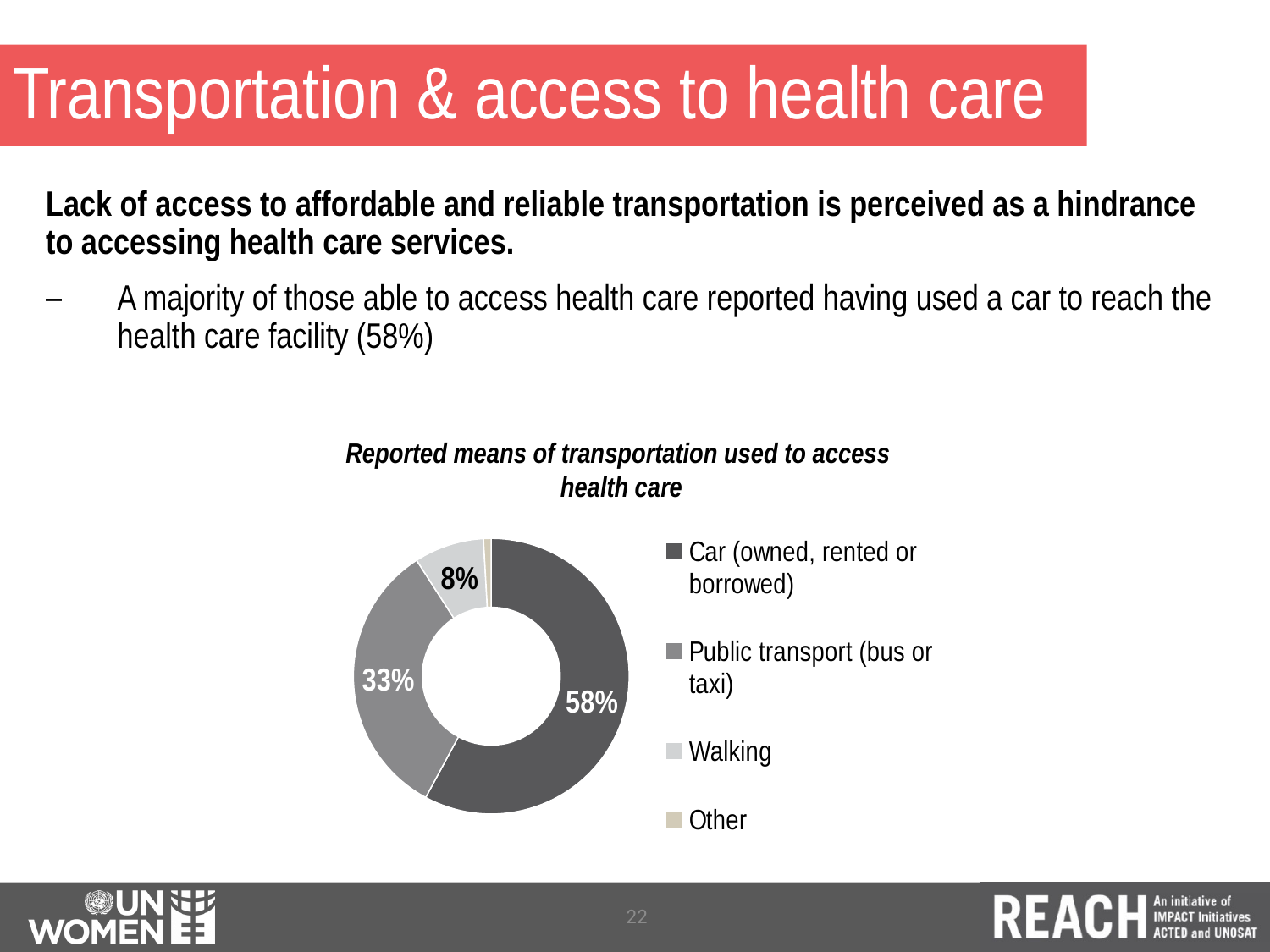
Which means of transportation has the largest share in the chart? Car (owned, rented or borrowed) Is the share for public transport (bus or taxi) greater or less than 50%? less Which is larger: the share for public transport (bus or taxi) or the share for walking? Public transport (bus or taxi) How many categories does the chart's legend list? 4 What kind of chart is shown on the slide? Pie chart (doughnut) What share of respondents reported using public transport (bus or taxi) to access health care? 33% Which means of transportation has the smallest share in the chart? Other What is the difference in percentage points between the car share and the public transport share? 25 percentage points What share of respondents reported walking to access health care? 8% Which legend entry is shown in the lightest grey colour? Walking What share of respondents reported using a car (owned, rented or borrowed) to access health care? 58% What is the title of the chart? Reported means of transportation used to access health care